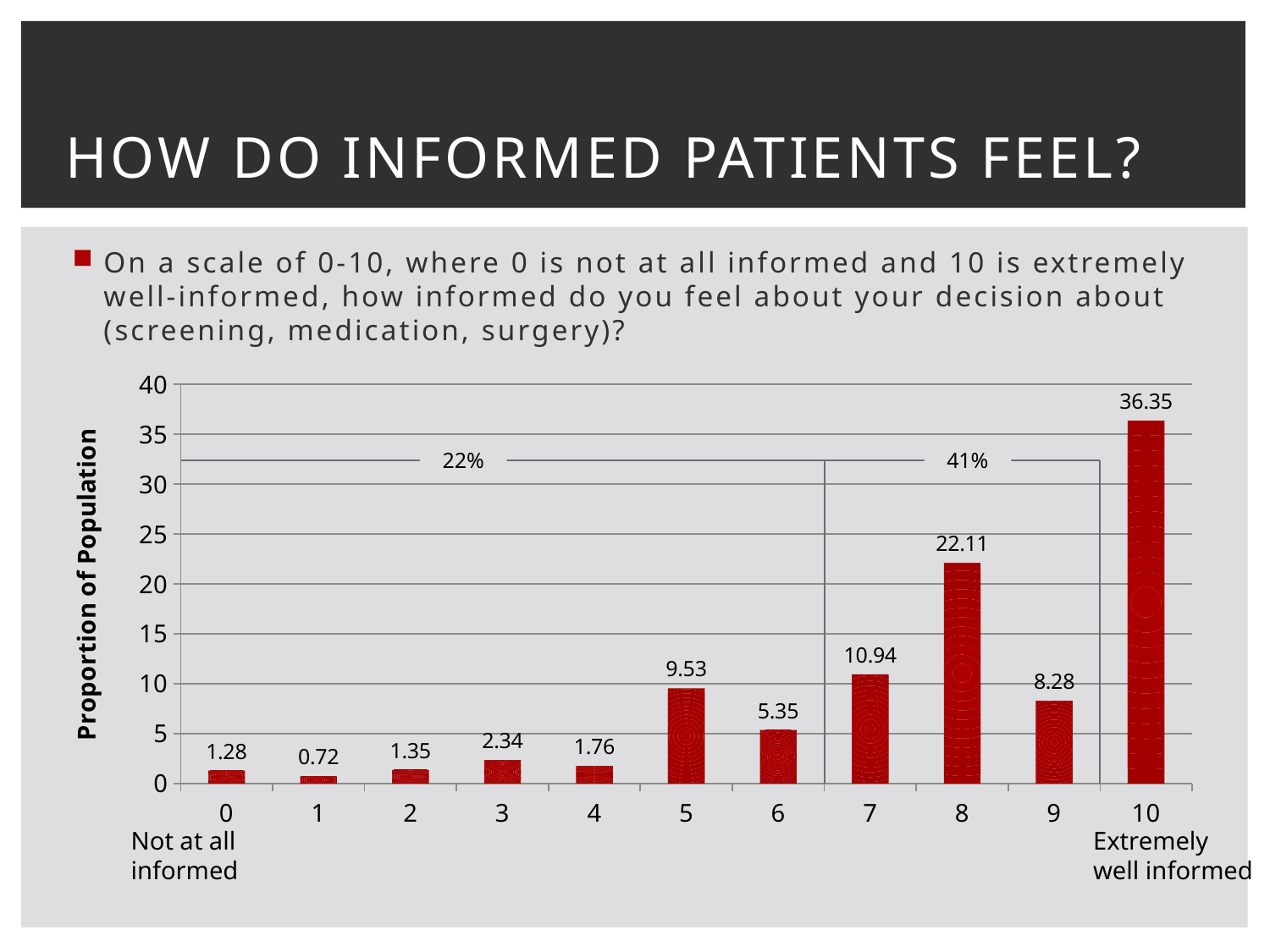
How many scale values (categories) are shown on the x axis? 11 What is the proportion of population for scale value 8? 22.11 What is the difference between the proportion for scale value 10 and scale value 8? 14.24 What is the label of the y axis? Proportion of Population What is the proportion of population for scale value 1? 0.72 Which has a larger proportion of population, scale value 7 or scale value 9? 7 Is the value for scale value 5 greater or less than 10? less Which scale value has the lowest proportion of population? 1 What is the proportion of population for scale value 10? 36.35 What percentage is annotated above the bars for scale values 0 to 6? 22% What kind of chart is shown on the slide? bar chart Which scale value has the highest proportion of population? 10